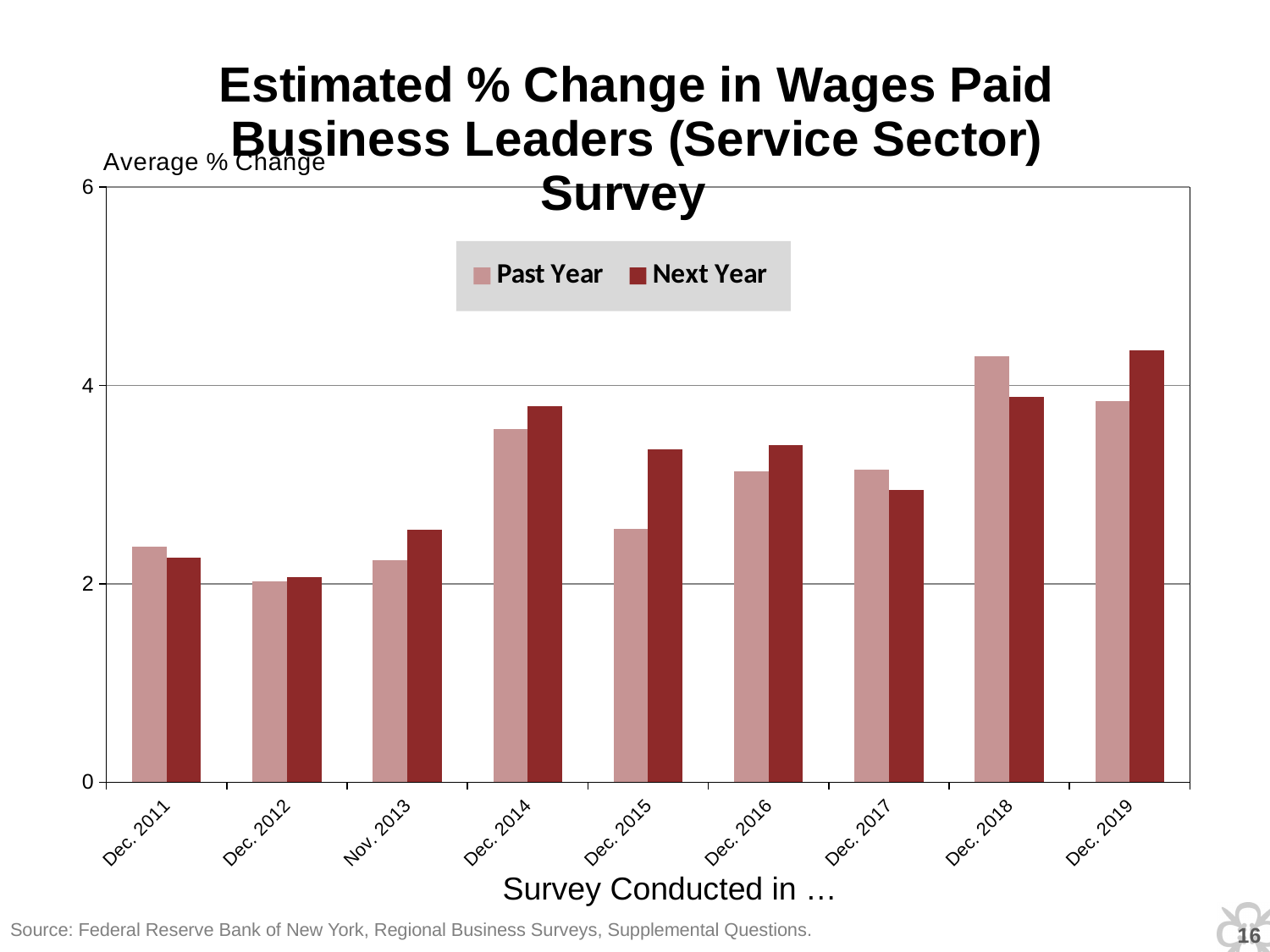
What kind of chart is shown on the slide? Bar chart Which survey date has the lowest Past Year value? Dec. 2012 Which survey date has the highest Next Year value? Dec. 2019 Is the Past Year value for Dec. 2018 greater or less than 4? greater How many series does the legend list? 2 Which survey date has the highest Past Year value? Dec. 2018 Is the Past Year value for Dec. 2015 greater or less than 2? greater Is the Next Year value for Dec. 2017 greater or less than 4? less What is the label on the y axis of the chart? Average % Change How many survey dates are shown along the x axis? 9 For Dec. 2018, which is larger: the Past Year value or the Next Year value? Past Year For Dec. 2015, which is larger: the Past Year value or the Next Year value? Next Year